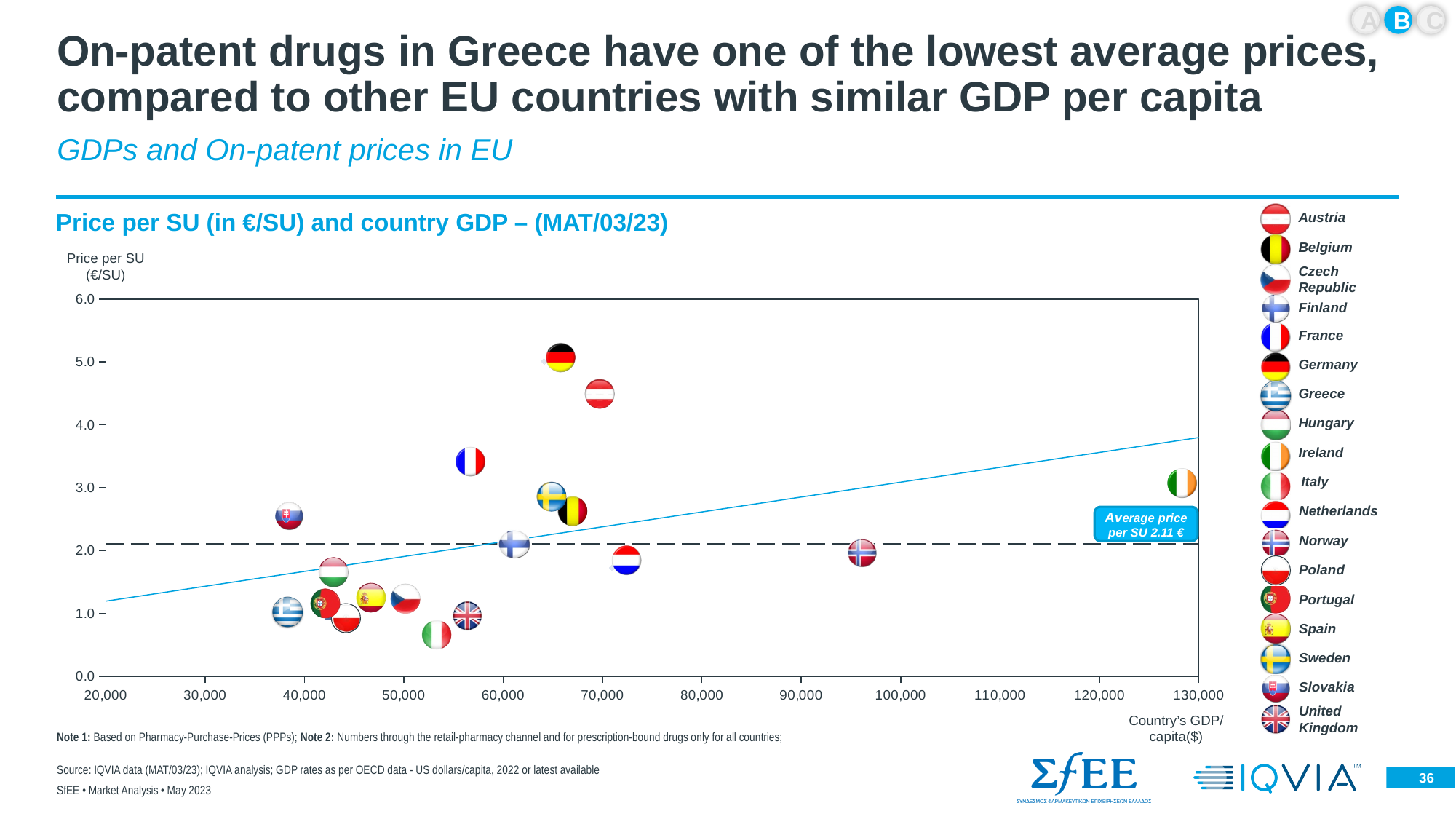
What is the average price per SU shown on the chart? 2.11 € What is the title of the chart? Price per SU (in €/SU) and country GDP – (MAT/03/23) Is the GDP per capita for Norway greater or less than 90,000? greater Which country has the highest GDP per capita on the chart? Ireland Which country has the highest price per SU on the chart? Germany Is the price per SU for France greater or less than 3.0? greater How many countries are listed in the chart's legend? 18 What kind of chart is shown on the slide? Scatter chart Is the price per SU for Germany greater or less than 4.0? greater Which has a higher price per SU, Germany or Austria? Germany Which country has the lowest price per SU on the chart? Italy